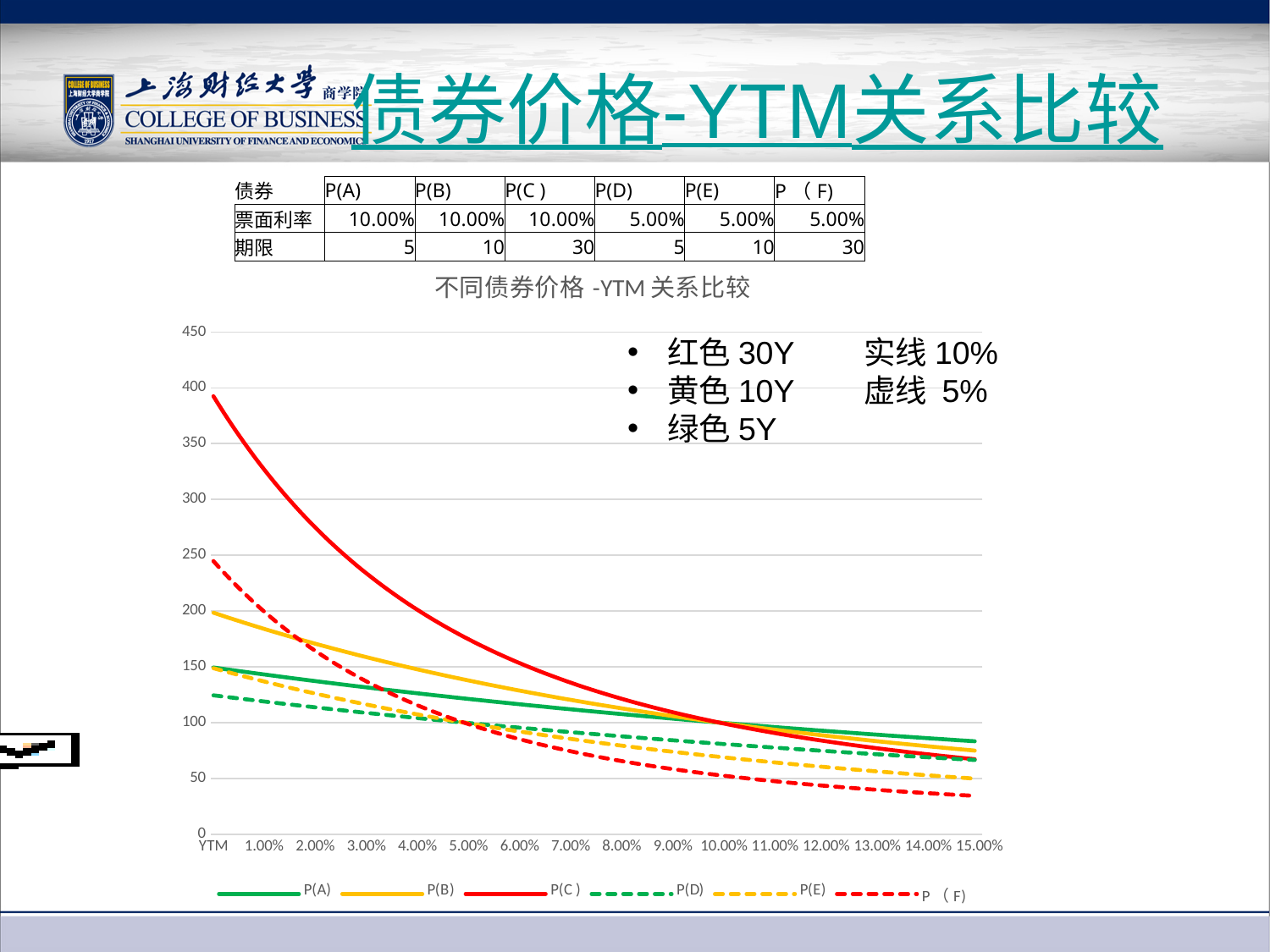
Which series has the lowest value at a YTM of 15.00%? P(F) Is the value of P(A) at a YTM of 15.00% greater or less than 100? less What kind of chart is shown on the slide? line chart Is the value of P(C) at a YTM of 1.00% greater or less than 350? less Is the value of P(F) at a YTM of 15.00% greater or less than 50? less Which series is drawn as a solid red line? P(C) At a YTM of 1.00%, which is larger, P(C) or P(B)? P(C) Do the bond prices rise or fall as YTM increases along the x axis? fall At a YTM of 15.00%, which is larger, P(A) or P(F)? P(A) What is the title of the chart? 不同债券价格 -YTM 关系比较 How many series does the chart legend list? 6 Which series has the highest value at a YTM of 1.00%? P(C)